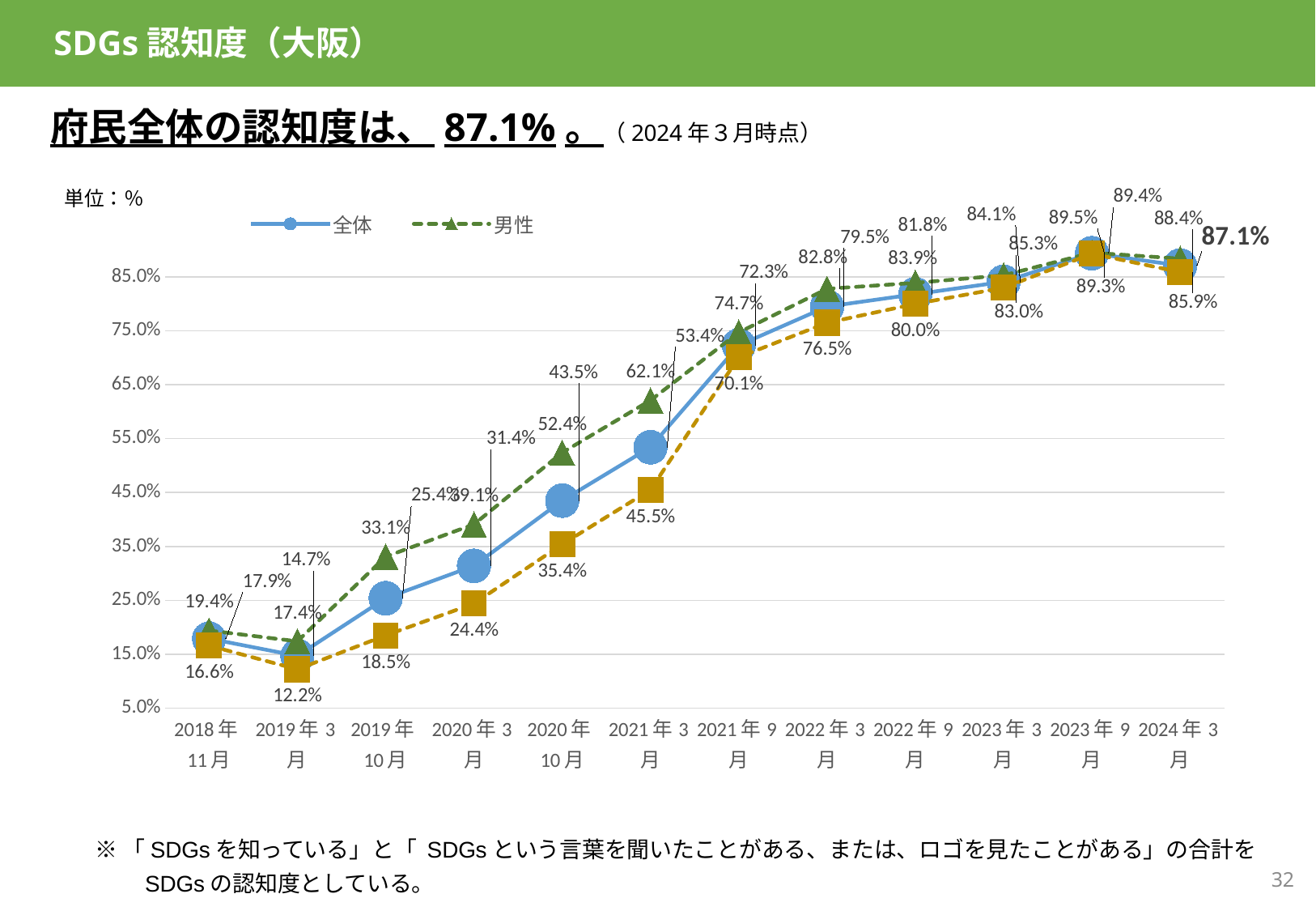
At which time point is the 全体 line at its highest? 2023年9月 What is the value for 全体 in 2024年3月? 87.1% What is the value for 男性 in 2024年3月? 88.4% What is the value for 全体 in 2021年3月? 53.4% Is the value for 全体 in 2021年3月 greater or less than 45%? greater Do the values for 全体 generally rise or fall from 2018年11月 to 2024年3月? rise What is the value for 男性 in 2020年10月? 52.4% How many time points are plotted along the x axis? 12 How many lines are plotted on the chart? 3 At which time point is the 全体 line at its lowest? 2019年3月 Which is larger in 2021年3月, the value for 男性 or the value for 全体? 男性 What kind of chart is shown on the slide? line chart